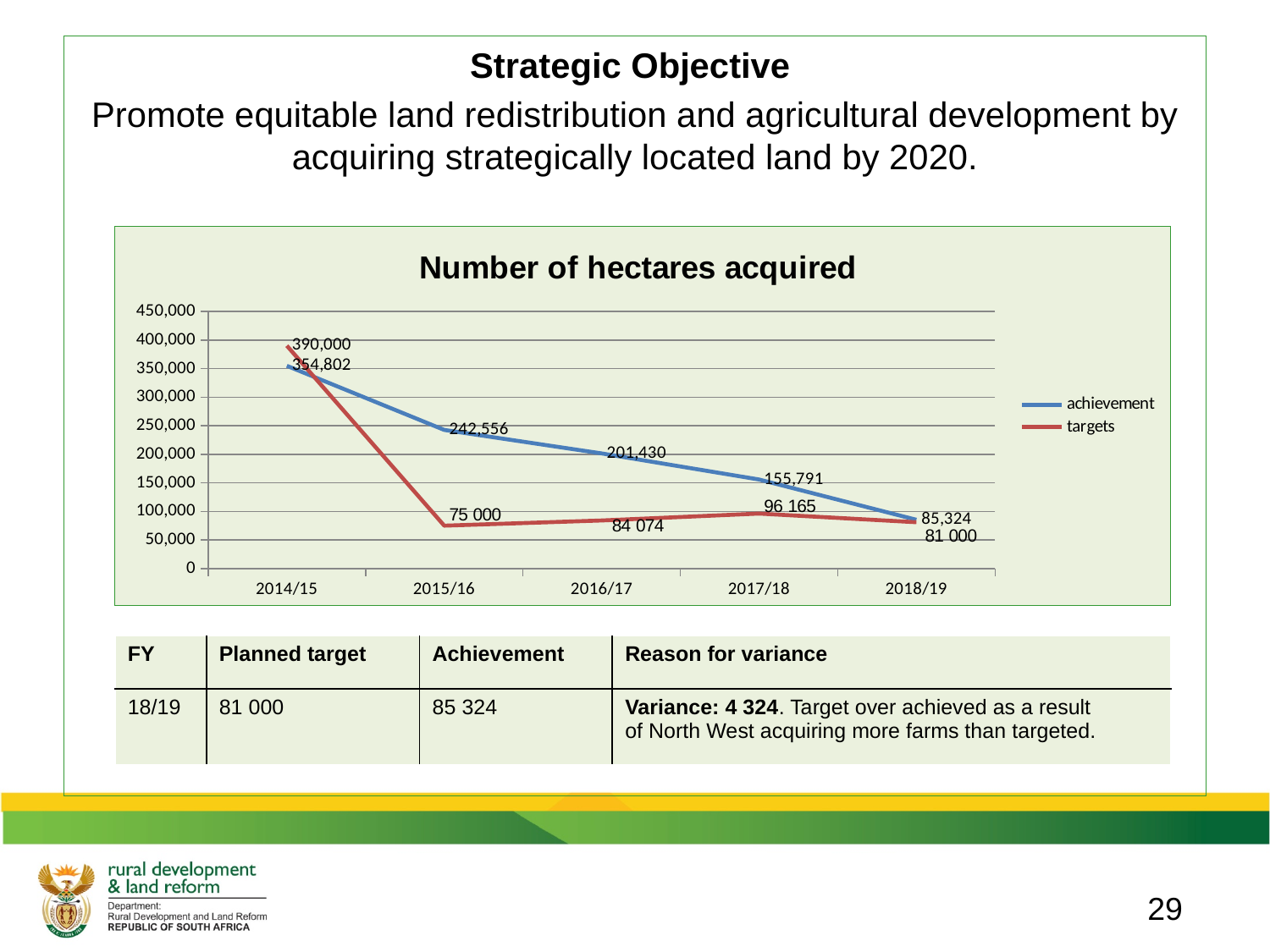
How many financial years are plotted on the x axis of the 'Number of hectares acquired' chart? 5 What is the targets value for 2014/15 in the 'Number of hectares acquired' chart? 390,000 In which financial year is the achievement series highest? 2014/15 How many series does the legend of the 'Number of hectares acquired' chart list? 2 Does the achievement series rise or fall from 2014/15 to 2018/19? fall What is the achievement value for 2015/16 in the 'Number of hectares acquired' chart? 242,556 What is the difference between the achievement and the target for 2018/19? 4 324 What is the targets value for 2017/18 in the 'Number of hectares acquired' chart? 96 165 Which is larger in 2016/17: the achievement or the target? achievement In which financial year is the targets series lowest? 2015/16 Which colour is used for the targets series in the chart? red What type of chart is shown under the title 'Number of hectares acquired'? line chart